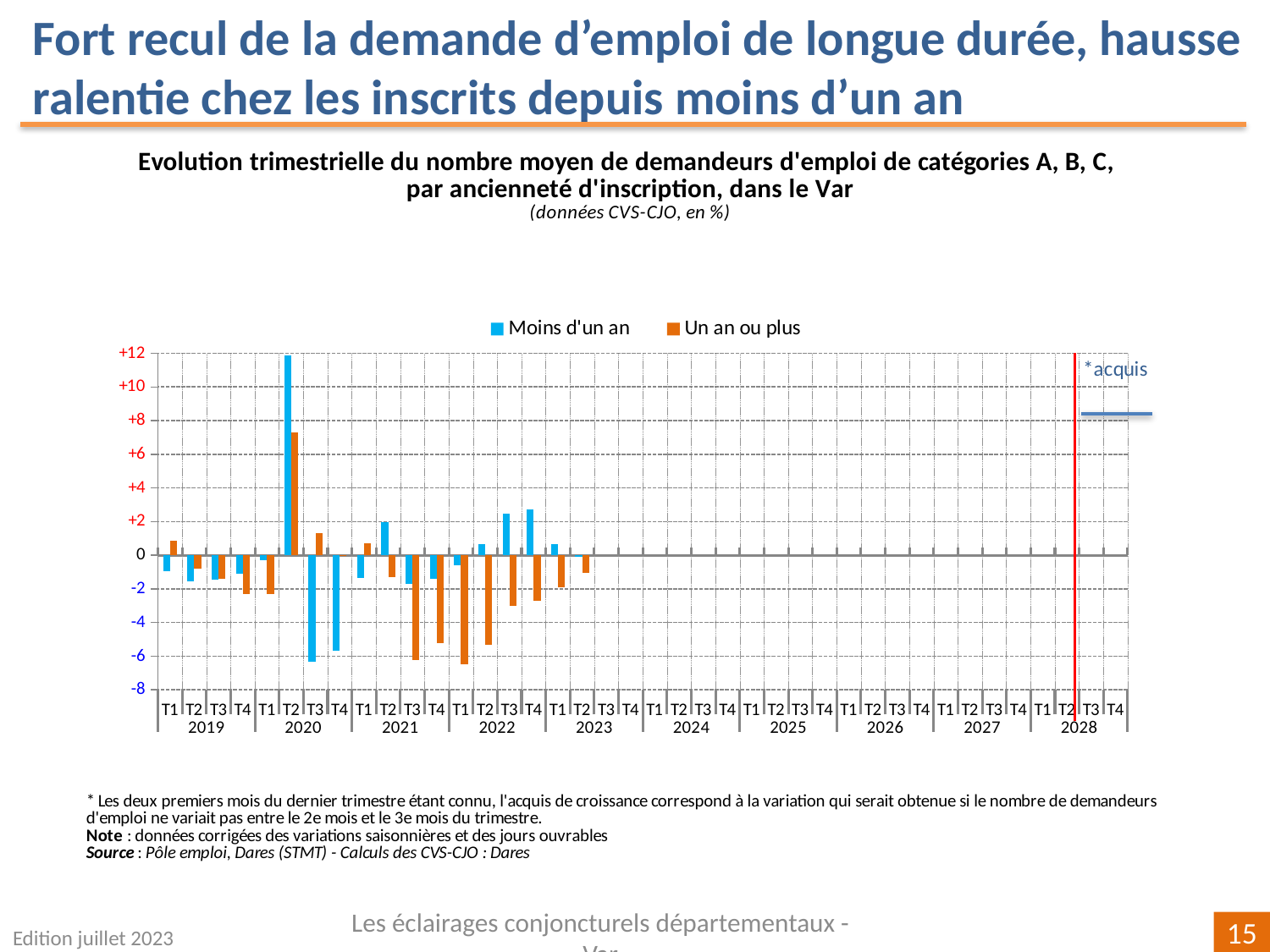
In T2 2020, which series has the larger value, 'Moins d'un an' or 'Un an ou plus'? Moins d'un an Is the value for 'Un an ou plus' in T2 2020 greater or less than +6? greater Is the value for 'Un an ou plus' in T1 2022 greater or less than -4? less Is the value for 'Moins d'un an' in T3 2020 greater or less than -4? less In T1 2022, which series has the larger value, 'Moins d'un an' or 'Un an ou plus'? Moins d'un an How many series does the legend list? 2 Which quarter has the highest value for the 'Un an ou plus' series? T2 2020 What kind of chart is shown on the slide? bar chart Which quarter has the highest value for the 'Moins d'un an' series? T2 2020 How many years are labelled along the x axis of the chart? 10 What are the two series named in the legend? Moins d'un an; Un an ou plus